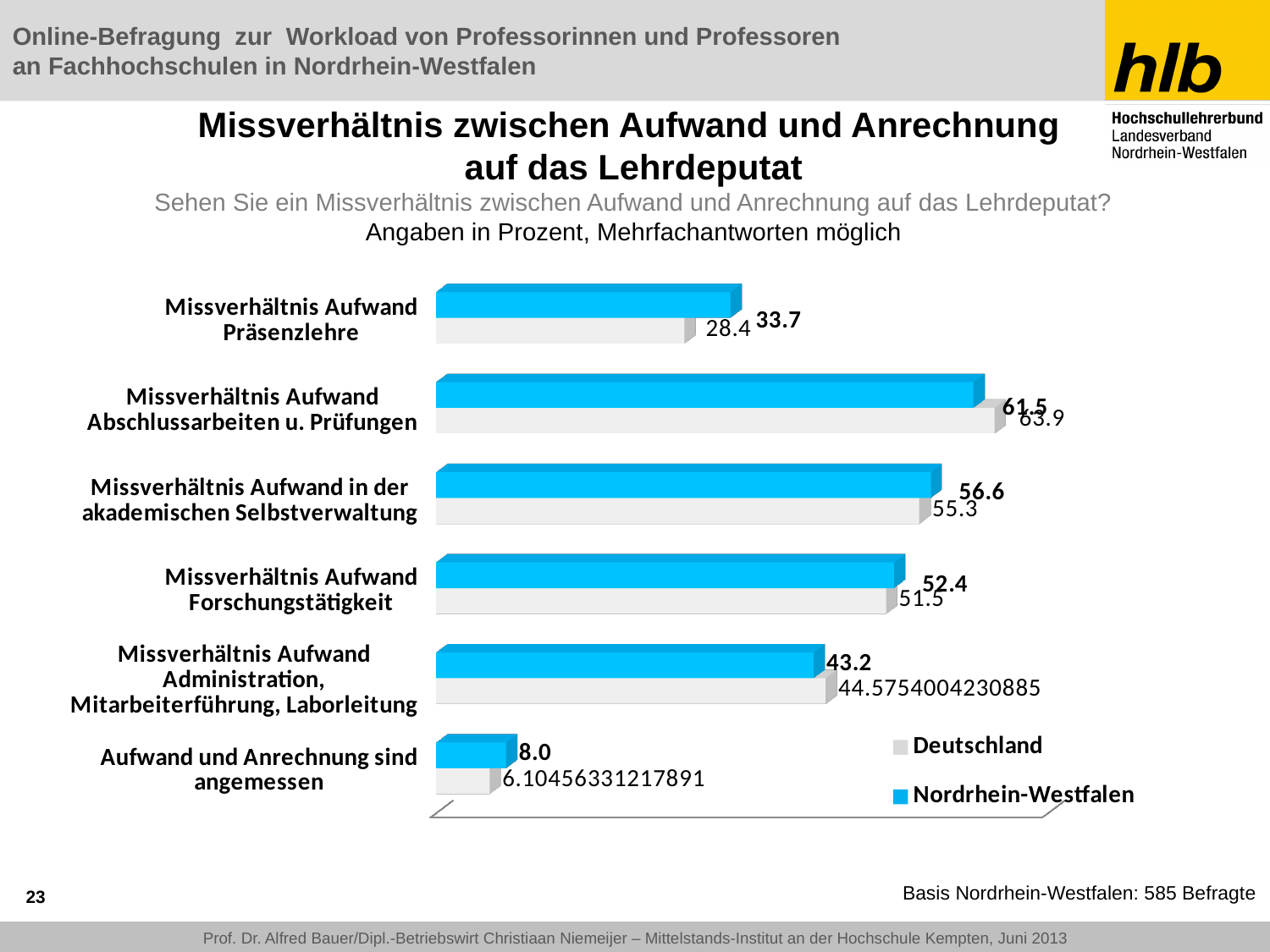
What is the value for Deutschland for "Missverhältnis Aufwand Administration, Mitarbeiterführung, Laborleitung"? 44.5754004230885 How many categories are shown in the chart? 6 What kind of chart is shown on the slide? Bar chart What is the value for Nordrhein-Westfalen for "Missverhältnis Aufwand in der akademischen Selbstverwaltung"? 56.6 Which category has the lowest value for Nordrhein-Westfalen? Aufwand und Anrechnung sind angemessen How many series does the legend list? 2 What is the value for Deutschland for "Missverhältnis Aufwand Präsenzlehre"? 28.4 What is the value for Nordrhein-Westfalen for "Missverhältnis Aufwand Präsenzlehre"? 33.7 For "Missverhältnis Aufwand Administration, Mitarbeiterführung, Laborleitung", which series has the larger value, Deutschland or Nordrhein-Westfalen? Deutschland Which category has the highest value for Nordrhein-Westfalen? Missverhältnis Aufwand Abschlussarbeiten u. Prüfungen What is the difference between the Nordrhein-Westfalen and Deutschland values for "Missverhältnis Aufwand Präsenzlehre"? 5.3 What is the value for Nordrhein-Westfalen for "Aufwand und Anrechnung sind angemessen"? 8.0